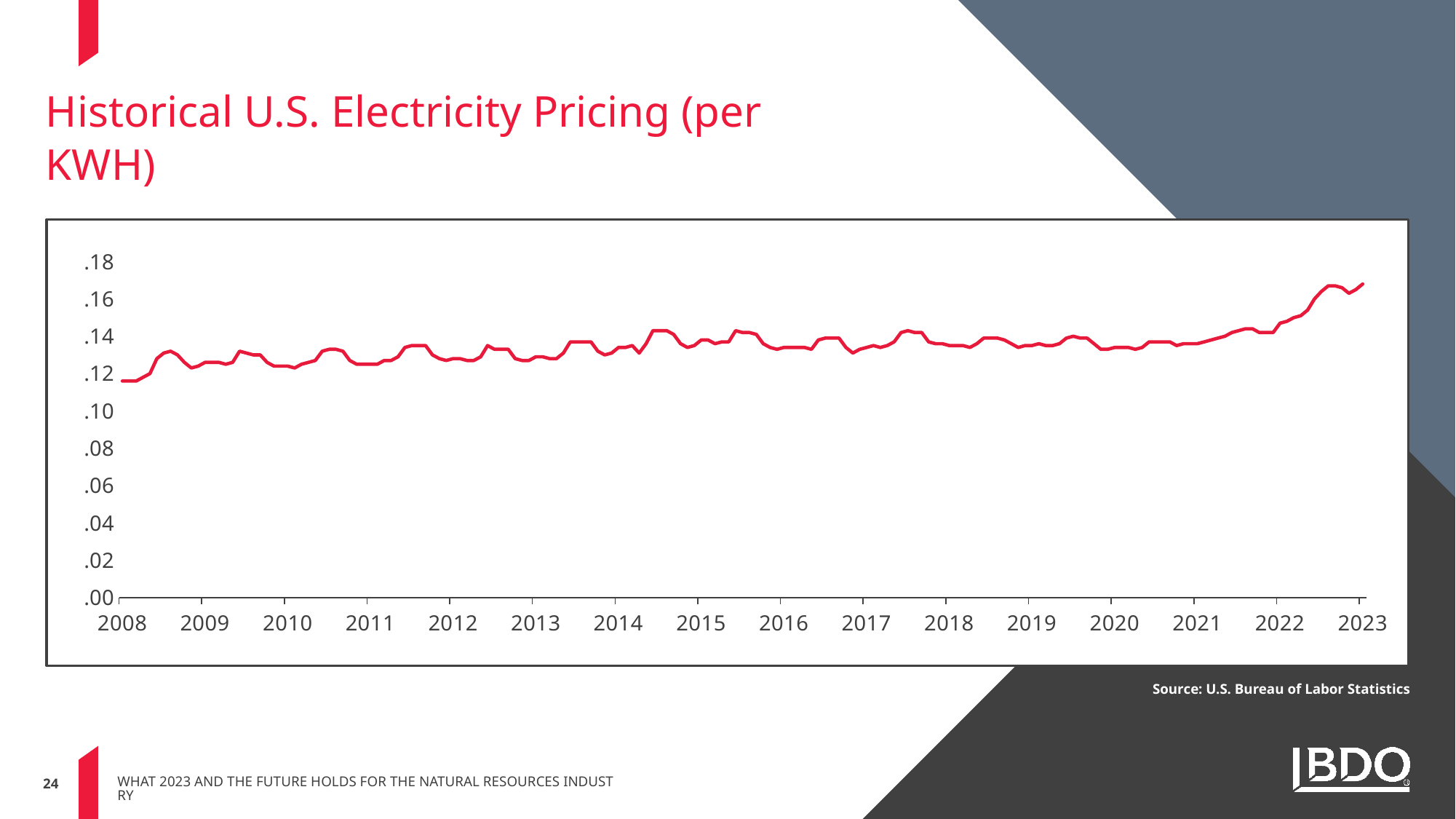
Is the value at 2008 greater or less than .14? less What is the title of the chart? Historical U.S. Electricity Pricing (per KWH) Which is larger, the value at 2008 or the value at 2023? 2023 What source is cited for the chart data? U.S. Bureau of Labor Statistics What kind of chart is shown on the slide? line chart Is the value at 2015 greater or less than .16? less In which year labelled on the x axis does the line reach its highest value? 2023 How many year labels are shown on the x axis? 16 Is the value at 2020 greater or less than .14? less Overall, do electricity prices rise or fall from 2008 to 2023? rise In which year labelled on the x axis is the line at its lowest value? 2008